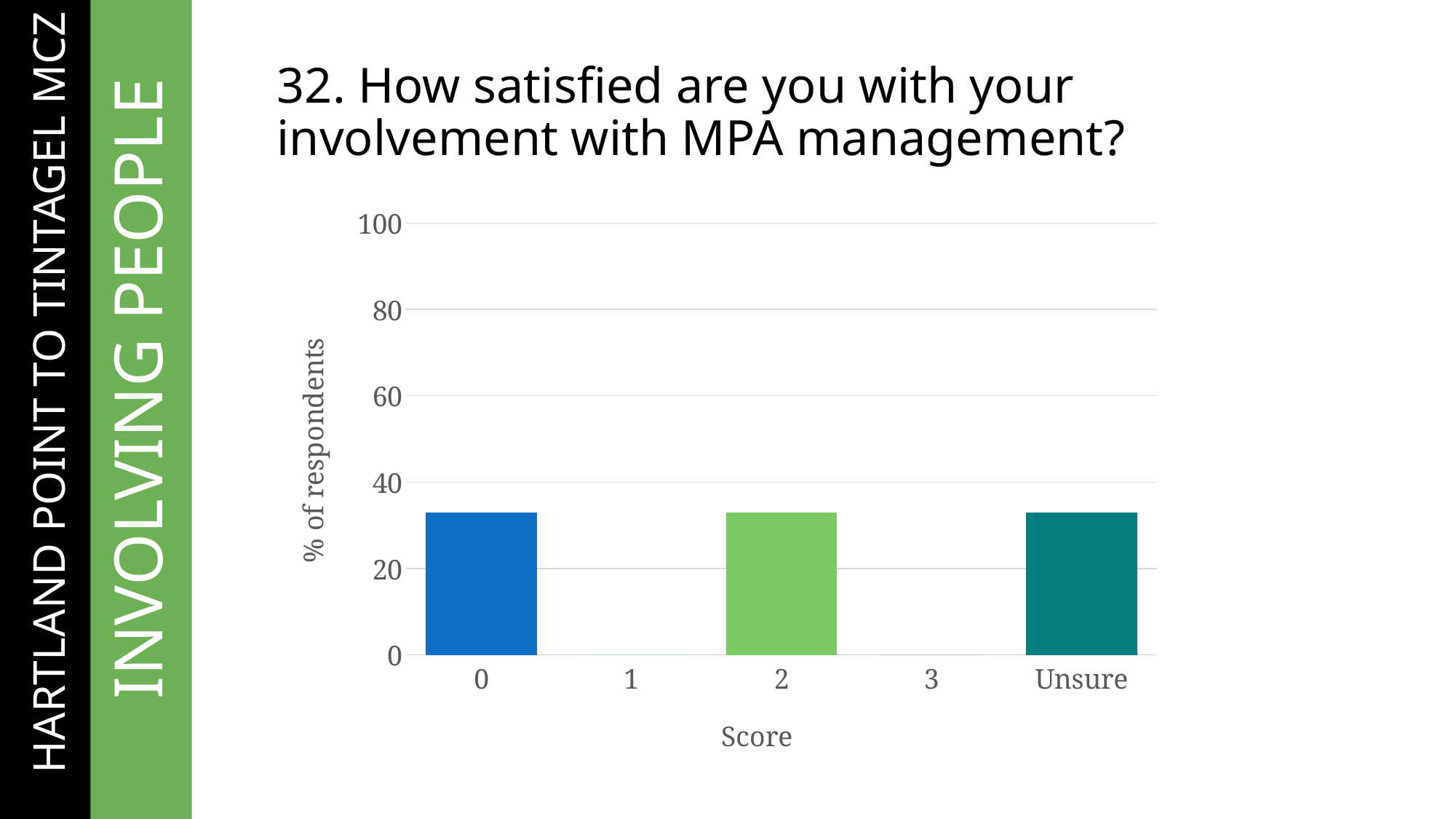
Is the value for score 0 greater or less than 20? greater What kind of chart is shown on the slide? bar chart Which is larger, the value for Unsure or the value for score 3? Unsure How many categories are shown on the x axis of the chart? 5 Is the value for score 2 greater or less than 20? greater What is the label of the x axis? Score Is the value for score 0 greater or less than 40? less Which is larger, the value for score 2 or the value for score 3? 2 What is the label of the y axis? % of respondents Which is larger, the value for score 0 or the value for score 1? 0